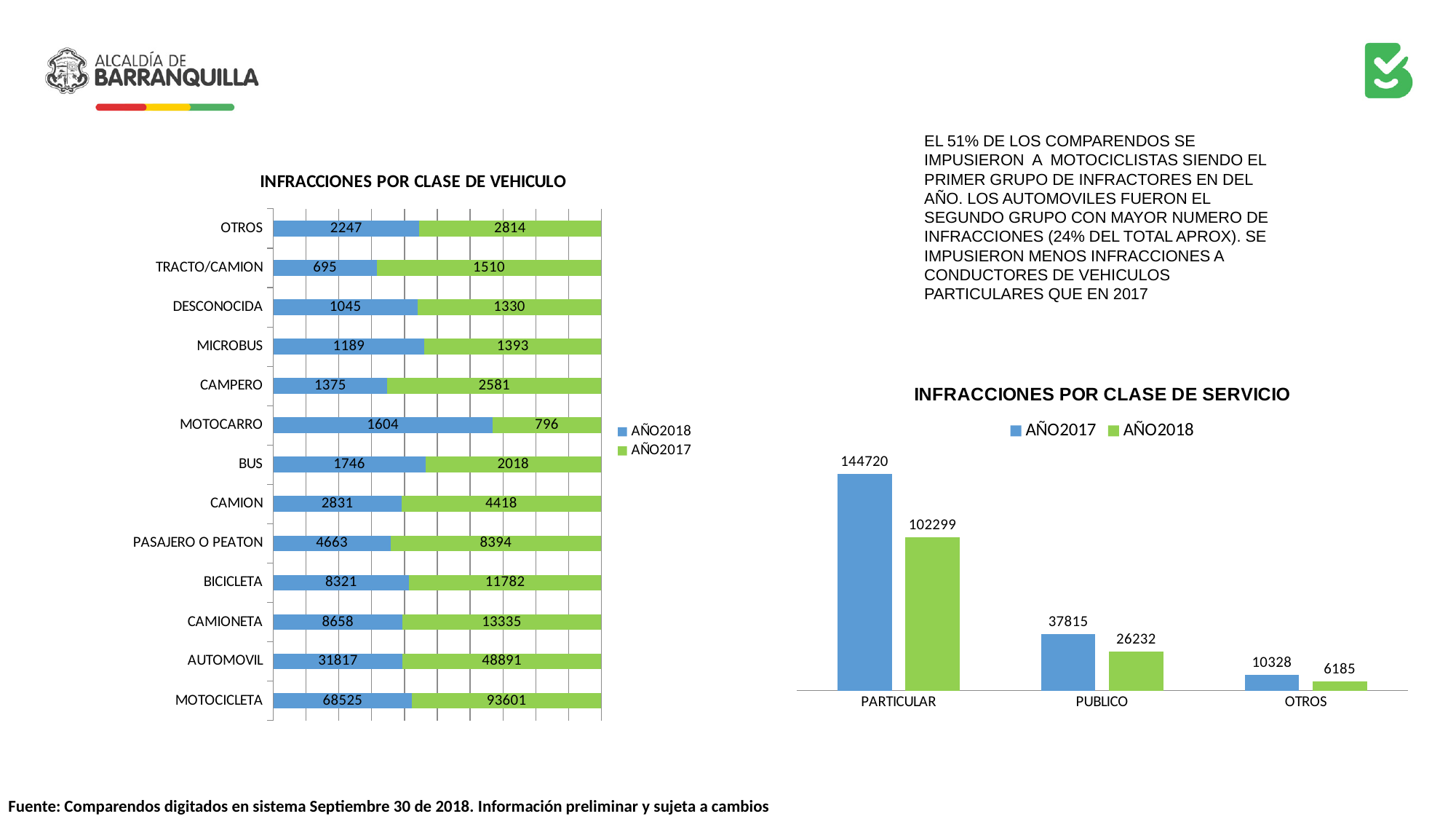
In the INFRACCIONES POR CLASE DE VEHICULO chart, is the AÑO2018 value for MOTOCARRO larger or smaller than its AÑO2017 value? larger In the INFRACCIONES POR CLASE DE VEHICULO chart, how many vehicle categories are shown? 13 In the INFRACCIONES POR CLASE DE VEHICULO chart, what is the AÑO2018 value for MOTOCICLETA? 68525 In the INFRACCIONES POR CLASE DE VEHICULO chart, what is the combined total of the AÑO2018 and AÑO2017 values for MOTOCARRO? 2400 What type of chart is INFRACCIONES POR CLASE DE SERVICIO? bar chart In the INFRACCIONES POR CLASE DE VEHICULO chart, which category has the highest AÑO2017 value? MOTOCICLETA In the INFRACCIONES POR CLASE DE SERVICIO chart, what is the AÑO2017 value for PUBLICO? 37815 How many series does the legend of the INFRACCIONES POR CLASE DE SERVICIO chart list? 2 In the INFRACCIONES POR CLASE DE VEHICULO chart, what is the AÑO2017 value for CAMIONETA? 13335 In the INFRACCIONES POR CLASE DE SERVICIO chart, which category has the lowest AÑO2018 value? OTROS In the INFRACCIONES POR CLASE DE SERVICIO chart, what is the difference between the AÑO2017 and AÑO2018 values for PARTICULAR? 42421 In the INFRACCIONES POR CLASE DE VEHICULO chart, which category has the lowest AÑO2018 value? TRACTO/CAMION